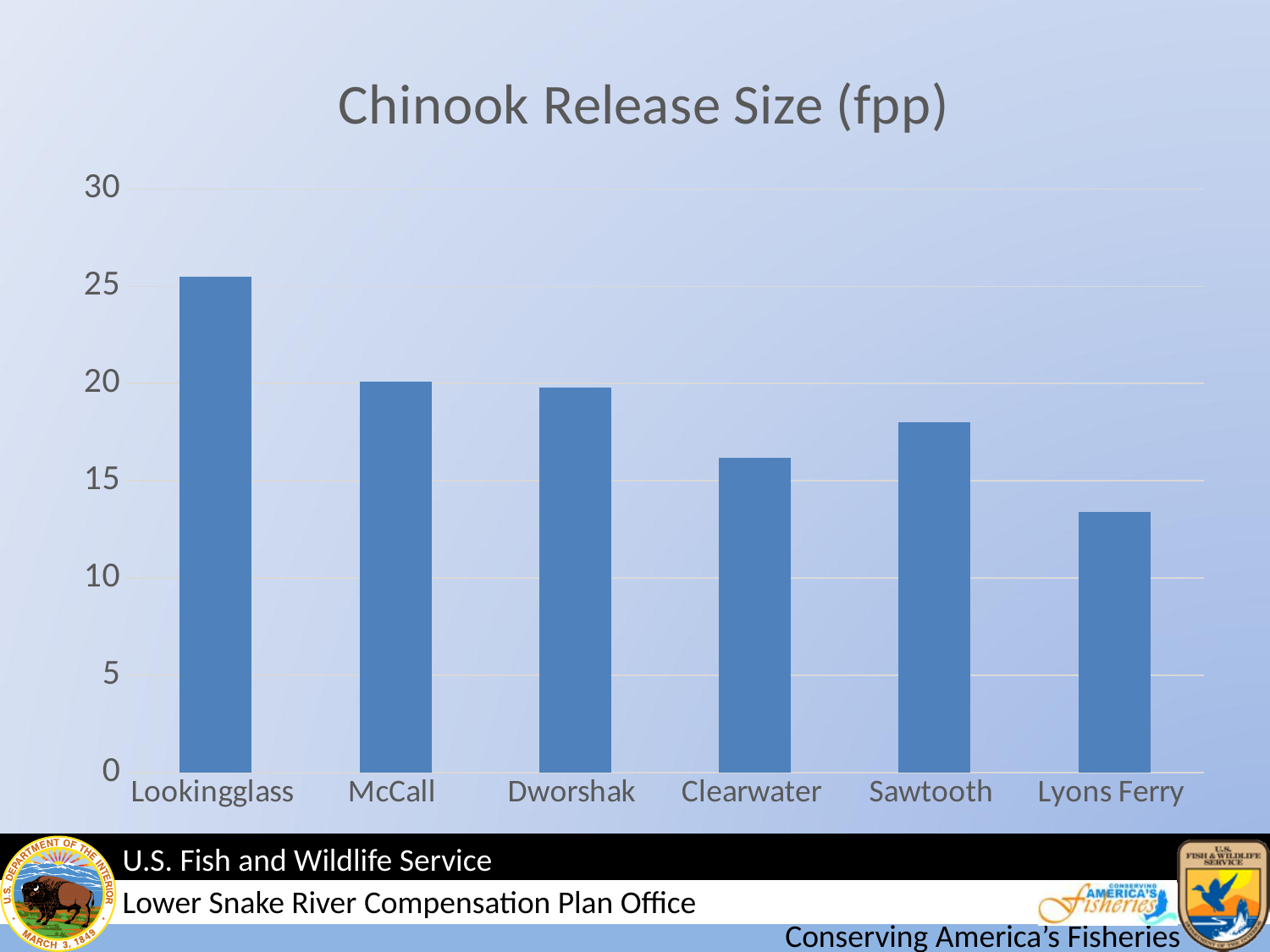
Which hatchery has the largest Chinook release size? Lookingglass What is the title of the chart? Chinook Release Size (fpp) What kind of chart is shown on the slide? bar chart Which has a larger release size, Lookingglass or McCall? Lookingglass Is the value for Lyons Ferry greater or less than 15? less Is the value for Clearwater greater or less than 15? greater How many hatcheries (categories) are shown on the x axis? 6 What is the highest value shown on the y axis? 30 Is the value for Sawtooth greater or less than 20? less Which has a larger release size, Sawtooth or Clearwater? Sawtooth Which hatchery has the smallest Chinook release size? Lyons Ferry